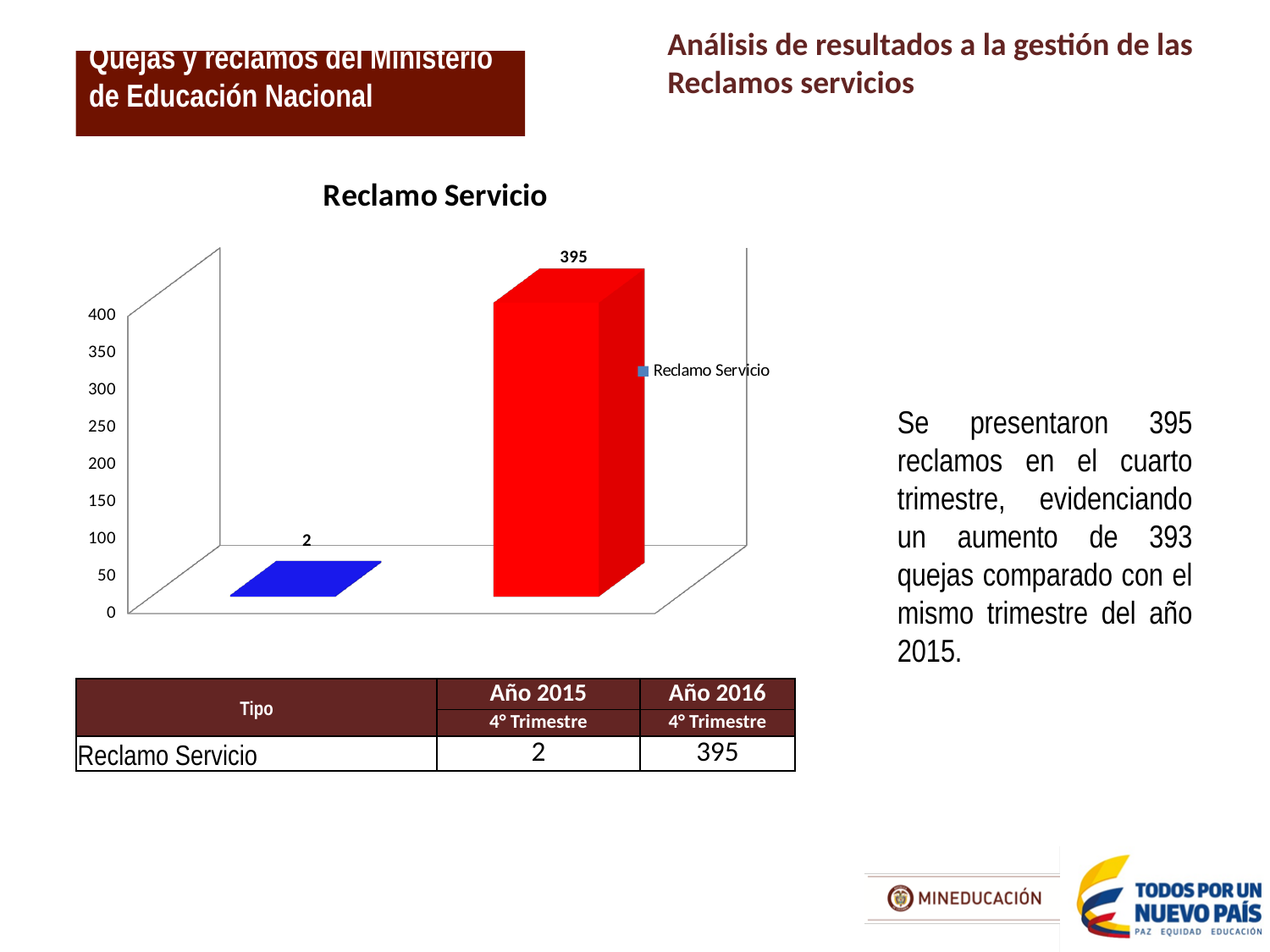
What type of chart is shown under the title "Reclamo Servicio"? bar chart Which bar in the "Reclamo Servicio" chart has the lowest value? the blue bar (2) What is the highest value shown on the vertical axis of the "Reclamo Servicio" chart? 400 What is the legend entry shown in the "Reclamo Servicio" chart? Reclamo Servicio What is the data label on the red bar in the "Reclamo Servicio" chart? 395 Which bar in the "Reclamo Servicio" chart has the higher value, the blue bar or the red bar? red bar Is the value of the red bar in the "Reclamo Servicio" chart greater or less than 350? greater How many bars are plotted in the "Reclamo Servicio" chart? 2 What is the data label on the blue bar in the "Reclamo Servicio" chart? 2 How many entries does the legend of the "Reclamo Servicio" chart list? 1 Do the values rise or fall from the left bar to the right bar in the "Reclamo Servicio" chart? rise What is the difference between the values of the red bar and the blue bar in the "Reclamo Servicio" chart? 393